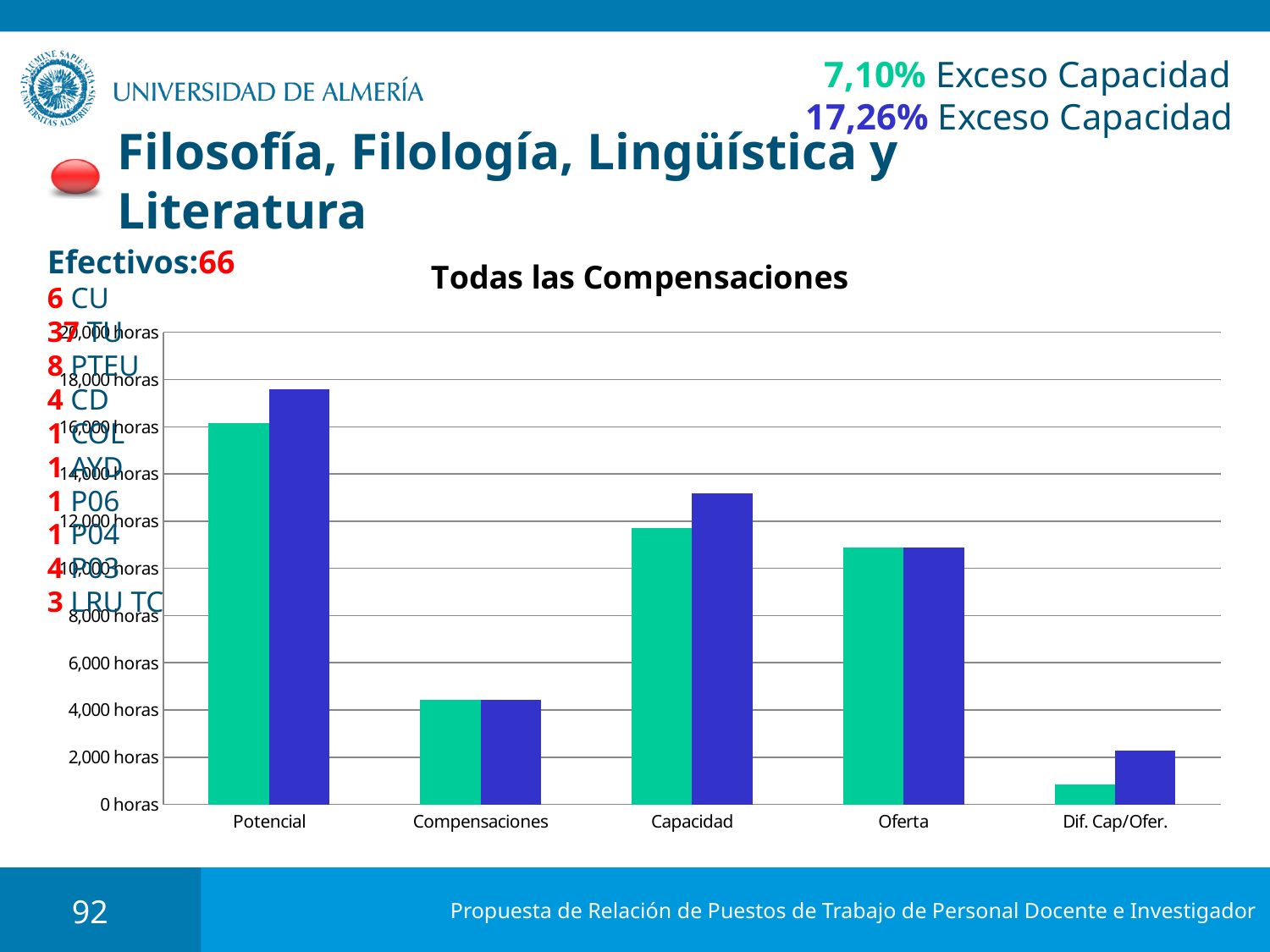
What is the title of the chart? Todas las Compensaciones Within the Potencial category, which bar is taller, the green one or the blue one? the blue one How many categories are shown on the x axis of the chart? 5 Are the values for Compensaciones greater or less than 6,000 horas? less Which category has the shortest bars in the chart? Dif. Cap/Ofer. Is the value of the green bar for Potencial greater or less than 14,000 horas? greater Is the value of the green bar for Dif. Cap/Ofer. greater or less than 2,000 horas? less Which category has larger values, Capacidad or Oferta? Capacidad Which category has the tallest bars in the chart? Potencial What kind of chart is shown on the slide? bar chart